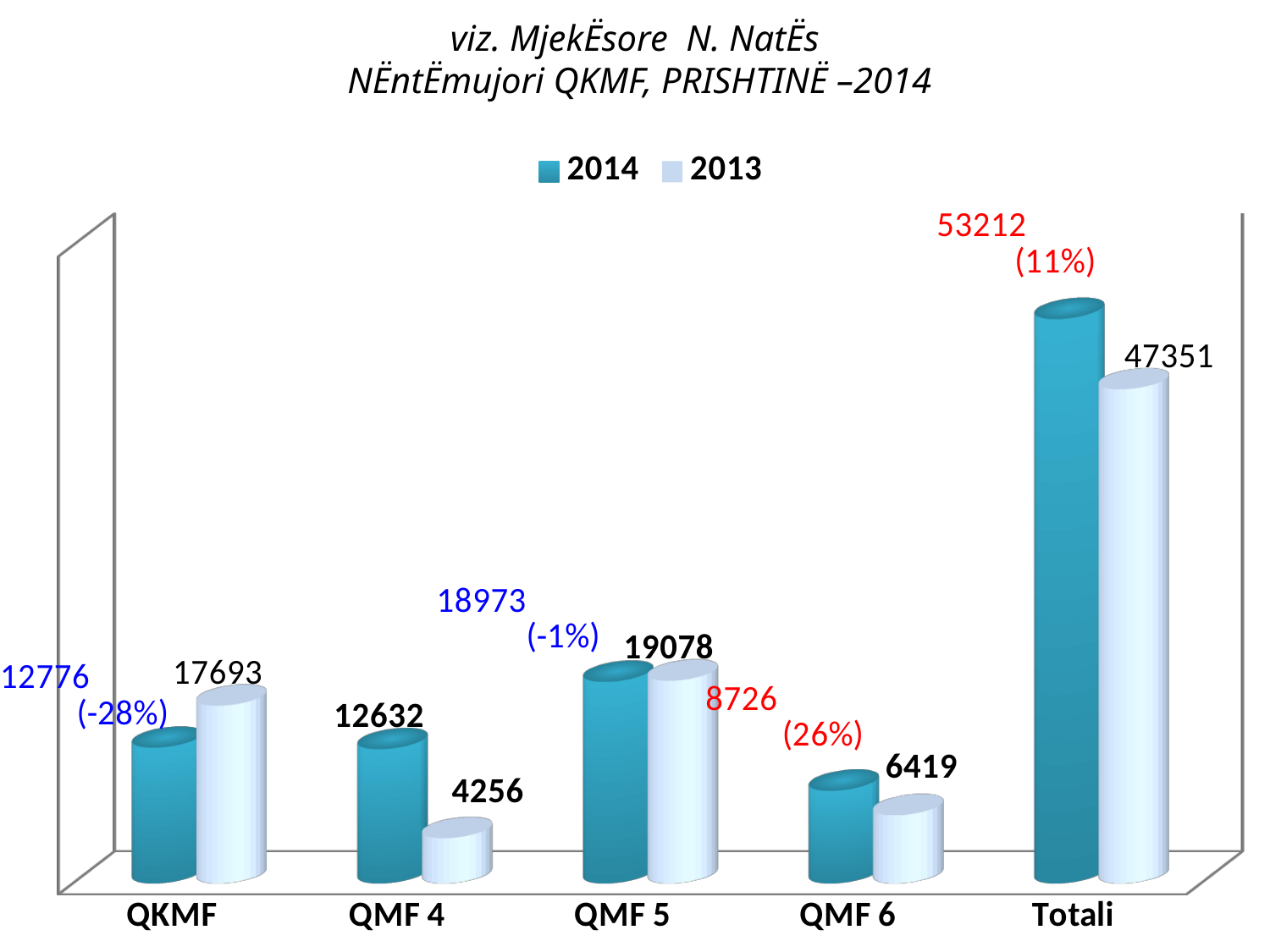
What is the difference between the 2014 and 2013 values for Totali? 5861 How many series does the legend list? 2 What is the 2013 value for QMF 4? 4256 What is the 2013 value for QMF 5? 19078 For QMF 6, which year has the larger value, 2014 or 2013? 2014 What percentage change is shown next to the 2014 value for QMF 6? 26% Excluding Totali, which category has the lowest 2013 value? QMF 4 What is the 2014 value for Totali? 53212 What is the 2014 value for QKMF? 12776 How many categories are shown on the x axis? 5 What is the difference between the 2013 and 2014 values for QKMF? 4917 Excluding Totali, which category has the highest 2014 value? QMF 5